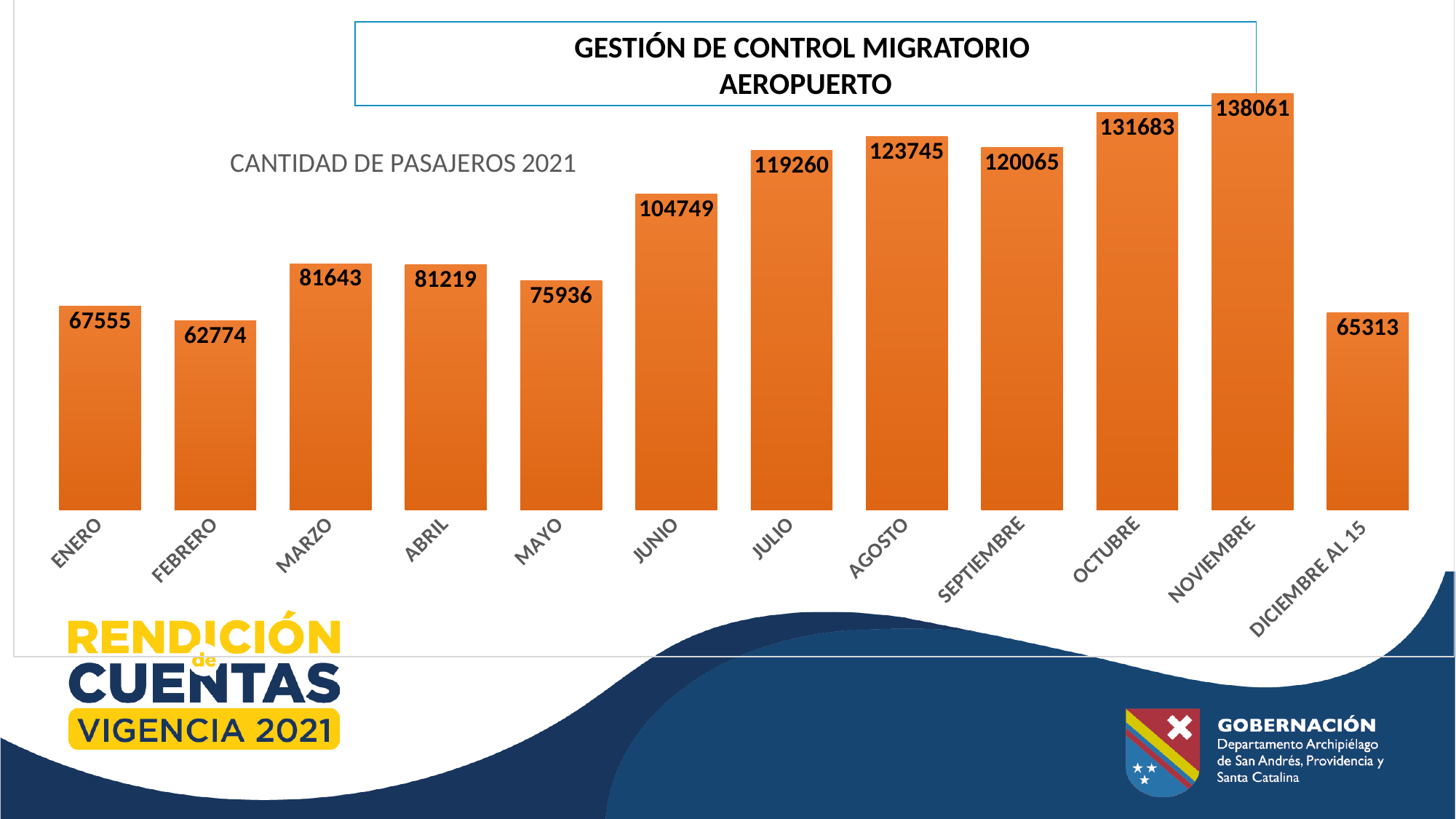
Which is larger, the value for ENERO or the value for MAYO? MAYO What is the title shown inside the chart area? CANTIDAD DE PASAJEROS 2021 What is the value for AGOSTO? 123745 Which month has the lowest value? FEBRERO What is the value for DICIEMBRE AL 15? 65313 What type of chart is shown on the slide? Bar chart Do the values rise or fall from MAYO to AGOSTO? Rise How many months (categories) are shown on the x axis of the chart? 12 What is the value for JUNIO? 104749 Which month has the highest value? NOVIEMBRE What is the difference between the values for NOVIEMBRE and FEBRERO? 75287 What is the difference between the values for OCTUBRE and SEPTIEMBRE? 11618